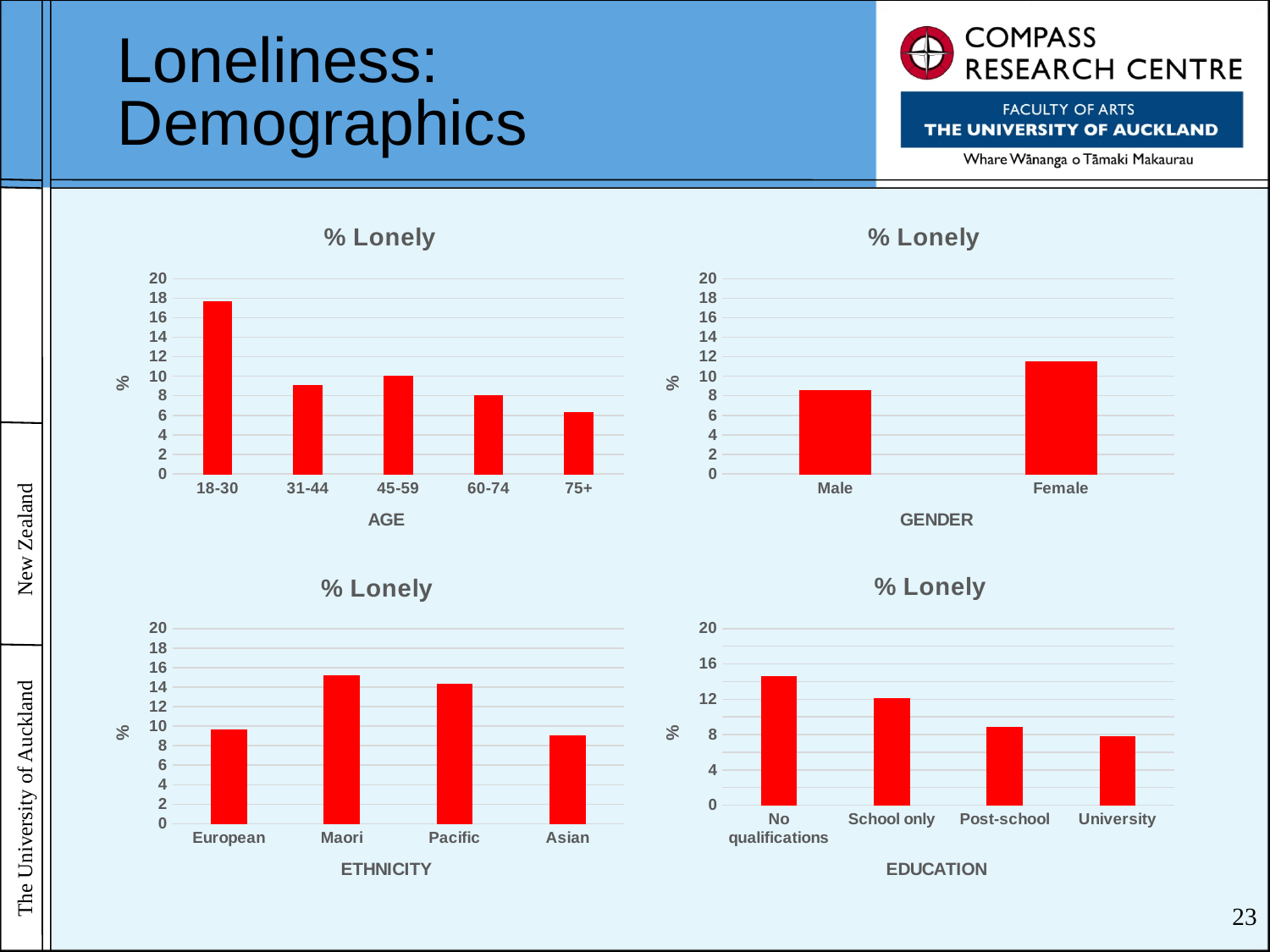
In the AGE chart, which age group has the lowest % Lonely? 75+ In the AGE chart, is the value for 18-30 greater or less than 16? greater In the GENDER chart, which is larger, the value for Male or Female? Female In the EDUCATION chart, is the value for No qualifications greater or less than 12? greater In the ETHNICITY chart, which ethnicity has the highest % Lonely? Maori In the AGE chart, how many age groups are shown? 5 In the GENDER chart, is the value for Male greater or less than 10? less In the AGE chart, which age group has the highest % Lonely? 18-30 What kind of chart is the GENDER chart? bar chart In the EDUCATION chart, do the values rise or fall from No qualifications to University? fall In the EDUCATION chart, which education level has the lowest % Lonely? University